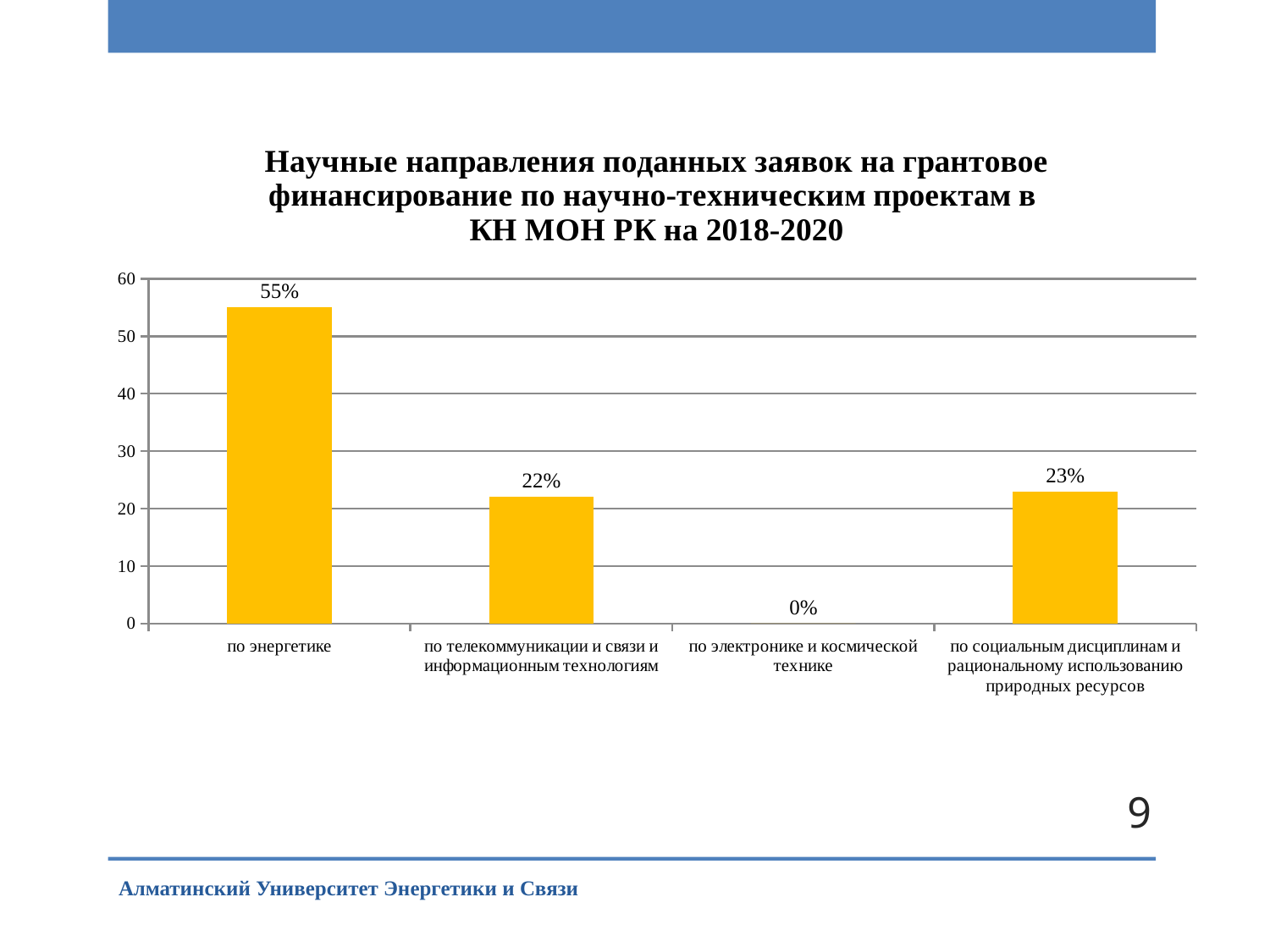
What is the value for "по энергетике"? 55% Which is larger: the value for "по энергетике" or the value for "по социальным дисциплинам и рациональному использованию природных ресурсов"? по энергетике What is the value for "по телекоммуникации и связи и информационным технологиям"? 22% What is the value for "по социальным дисциплинам и рациональному использованию природных ресурсов"? 23% Which category has the highest value? по энергетике What colour are the bars in the chart? yellow Which category has the lowest value? по электронике и космической технике How many categories are shown on the x axis? 4 Is the value for "по энергетике" greater or less than 50? greater What is the value for "по электронике и космической технике"? 0% What is the difference between the values for "по энергетике" and "по телекоммуникации и связи и информационным технологиям"? 33% What kind of chart is shown on the slide? bar chart